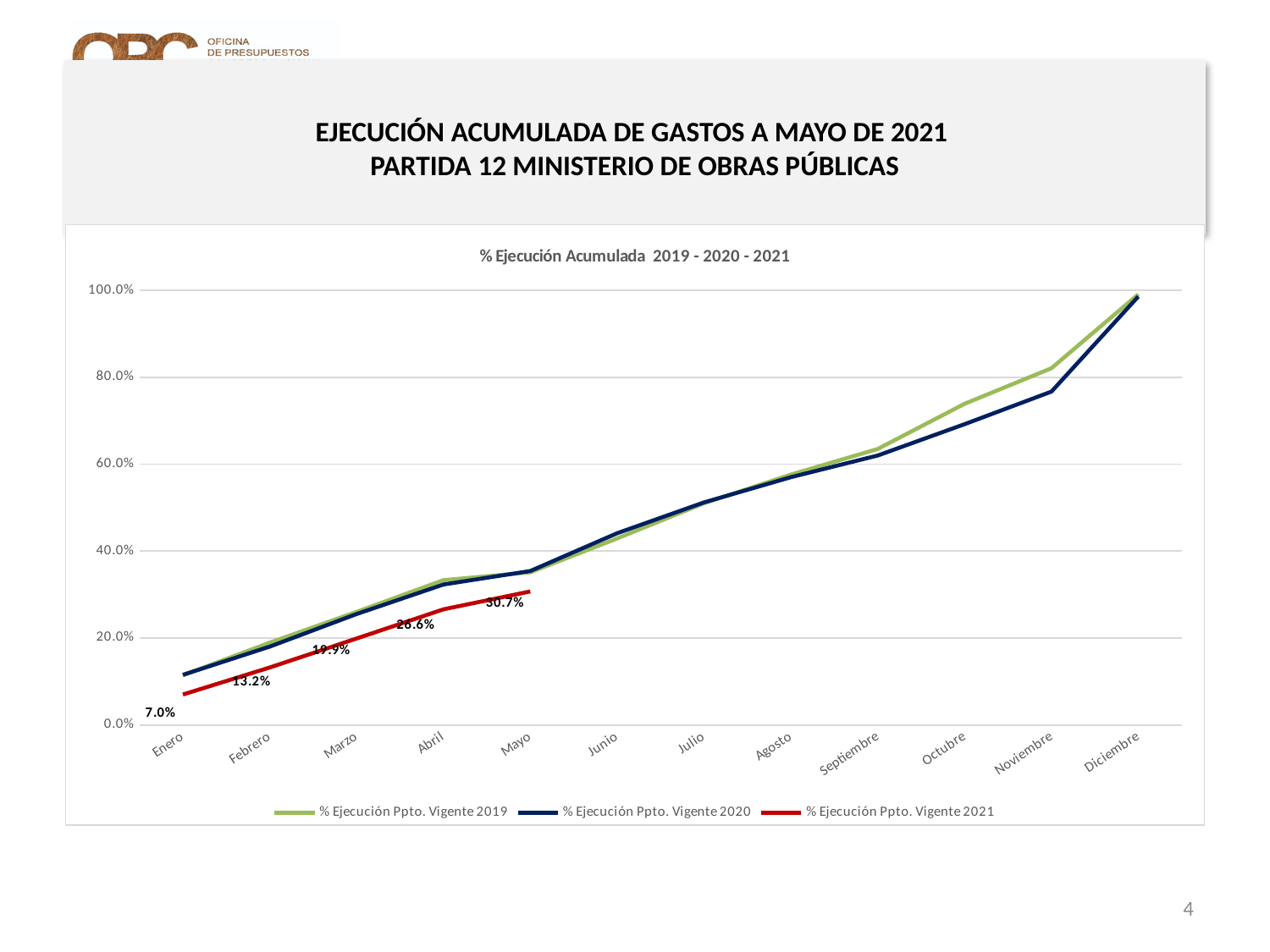
What kind of chart is shown on the slide? line chart How many series does the legend list? 3 Is the value for Enero in the % Ejecución Ppto. Vigente 2020 series greater or less than 20.0%? less Do the values of the % Ejecución Ppto. Vigente 2019 series rise or fall from Enero to Diciembre? rise How many months are shown along the x axis? 12 Which is larger in the % Ejecución Ppto. Vigente 2021 series, the value for Mayo or the value for Enero? Mayo What is the value for Mayo in the % Ejecución Ppto. Vigente 2021 series? 30.7% What is the difference between the Febrero and Enero values in the % Ejecución Ppto. Vigente 2021 series? 6.2% What is the value for Febrero in the % Ejecución Ppto. Vigente 2021 series? 13.2% What is the value for Enero in the % Ejecución Ppto. Vigente 2021 series? 7.0% Is the value for Noviembre in the % Ejecución Ppto. Vigente 2020 series greater or less than 80.0%? less What is the title of the chart? % Ejecución Acumulada 2019 - 2020 - 2021